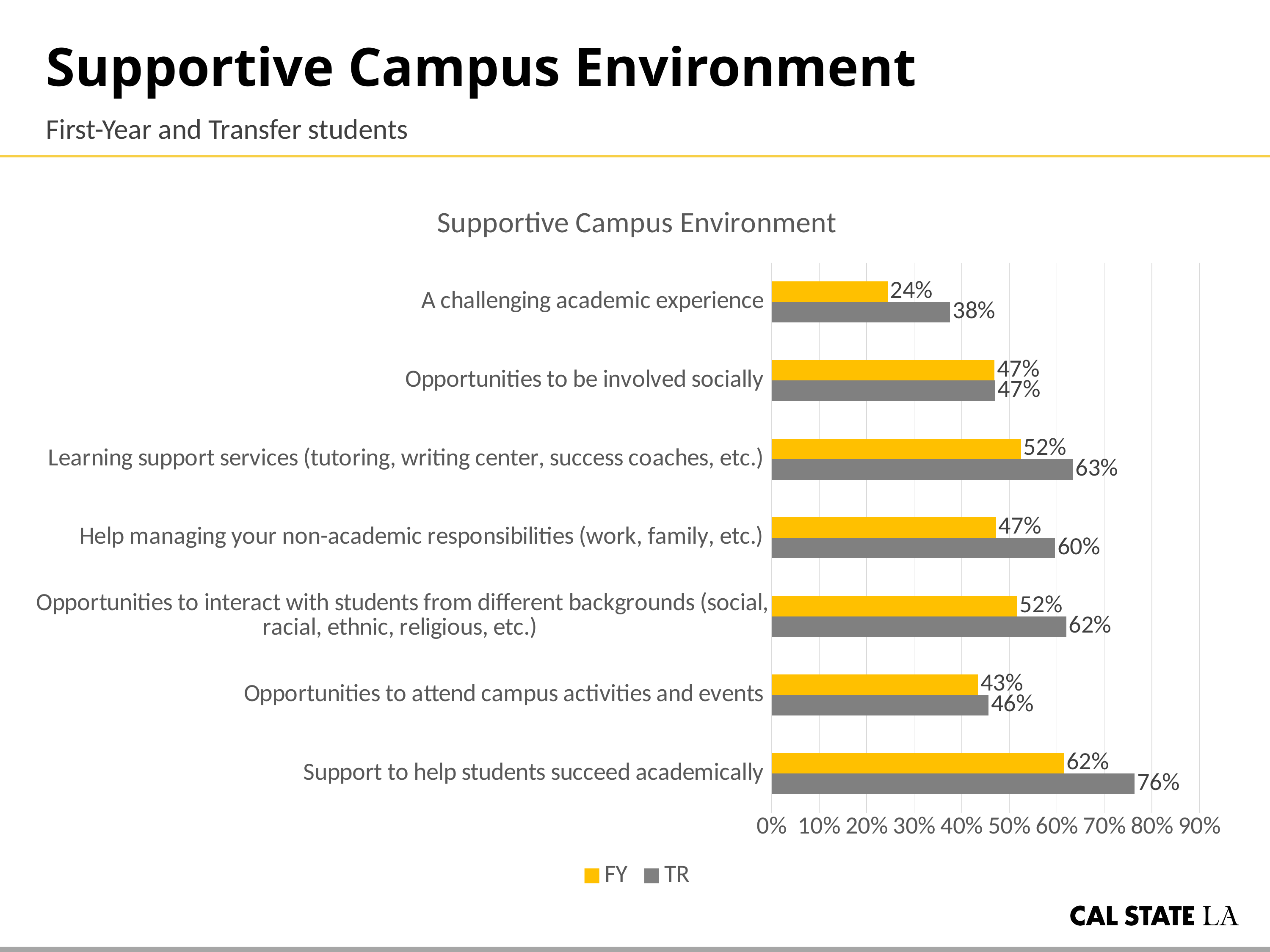
Which is larger for "Help managing your non-academic responsibilities (work, family, etc.)": the FY value or the TR value? TR What is the FY value for "A challenging academic experience"? 24% What is the FY value for "Opportunities to attend campus activities and events"? 43% Which category has the lowest FY value? A challenging academic experience What is the difference between the TR and FY values for "Support to help students succeed academically"? 14% What is the difference between the TR and FY values for "A challenging academic experience"? 14% What kind of chart is shown on the slide? Bar chart What is the TR value for "Support to help students succeed academically"? 76% Which category has the highest TR value? Support to help students succeed academically How many series does the legend list? 2 How many categories are shown in the chart? 7 What is the TR value for "Learning support services (tutoring, writing center, success coaches, etc.)"? 63%